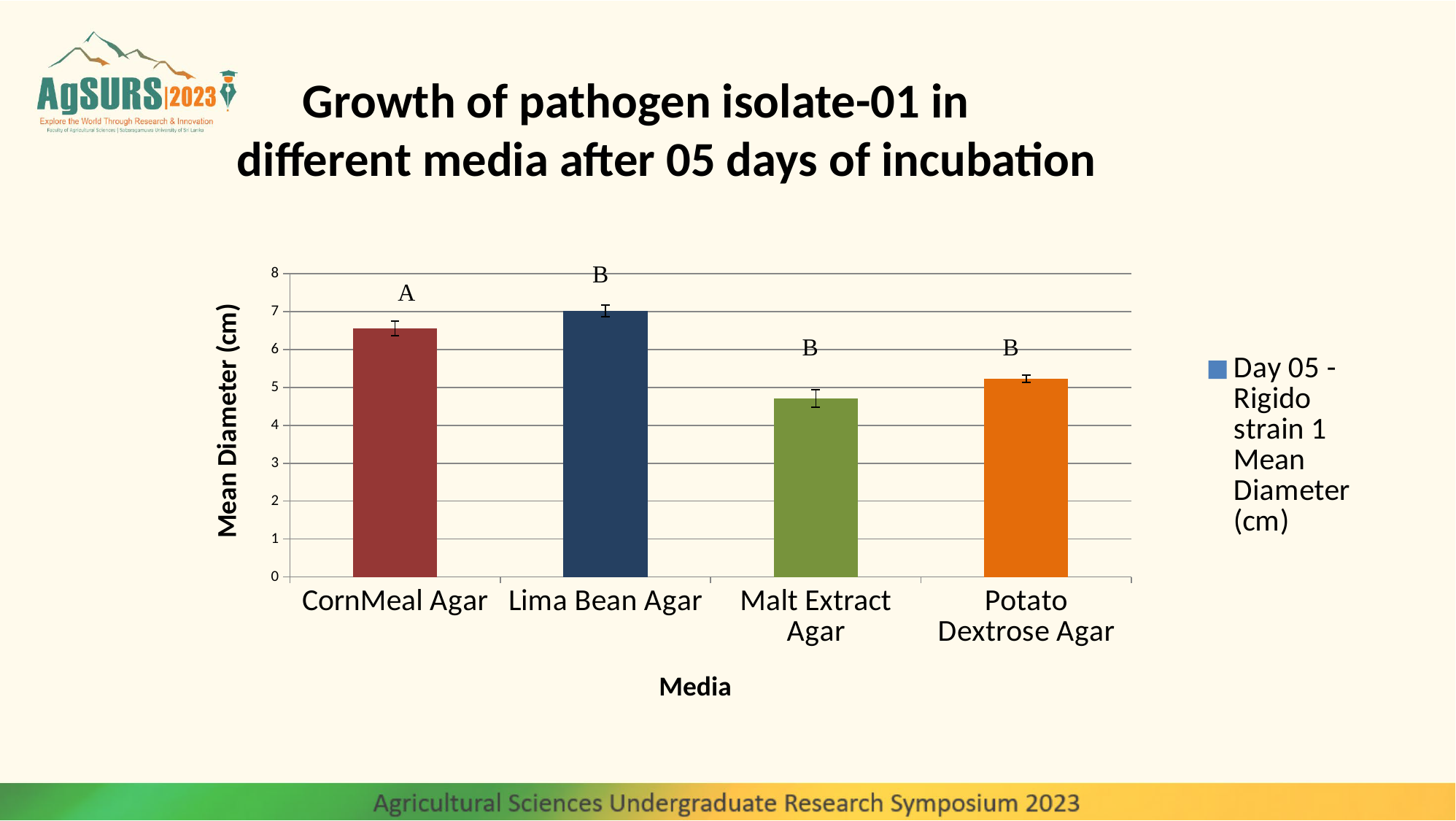
Which medium has the highest mean diameter? Lima Bean Agar Is the mean diameter for CornMeal Agar greater or less than 6? greater What kind of chart is shown on the slide? bar chart Which medium has the lowest mean diameter? Malt Extract Agar Which has a larger mean diameter, Malt Extract Agar or Lima Bean Agar? Lima Bean Agar What is the label of the y axis? Mean Diameter (cm) How many series does the legend list? 1 Is the mean diameter for Potato Dextrose Agar greater or less than 5? greater Is the mean diameter for Malt Extract Agar greater or less than 5? less Which has a larger mean diameter, CornMeal Agar or Potato Dextrose Agar? CornMeal Agar How many media categories are plotted on the x axis? 4 What is the label of the x axis? Media